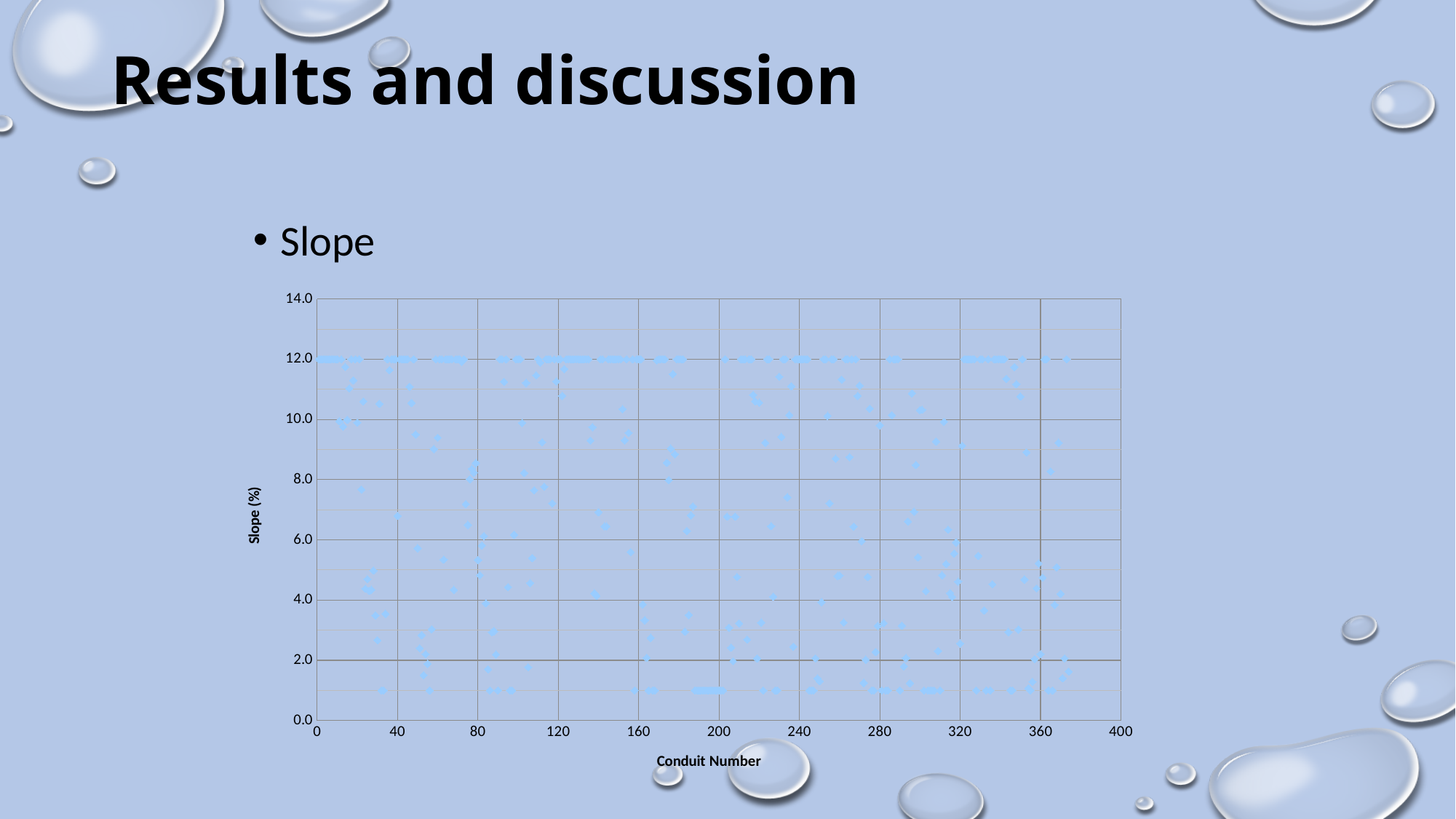
What is the label of the vertical axis of the chart? Slope (%) Is the lowest plotted slope value greater or less than 0.0? greater What kind of chart is shown on the slide? scatter chart Is the lowest plotted slope value greater or less than 2.0? less What is the label of the horizontal axis of the chart? Conduit Number Is the highest plotted slope value greater or less than 14.0? less